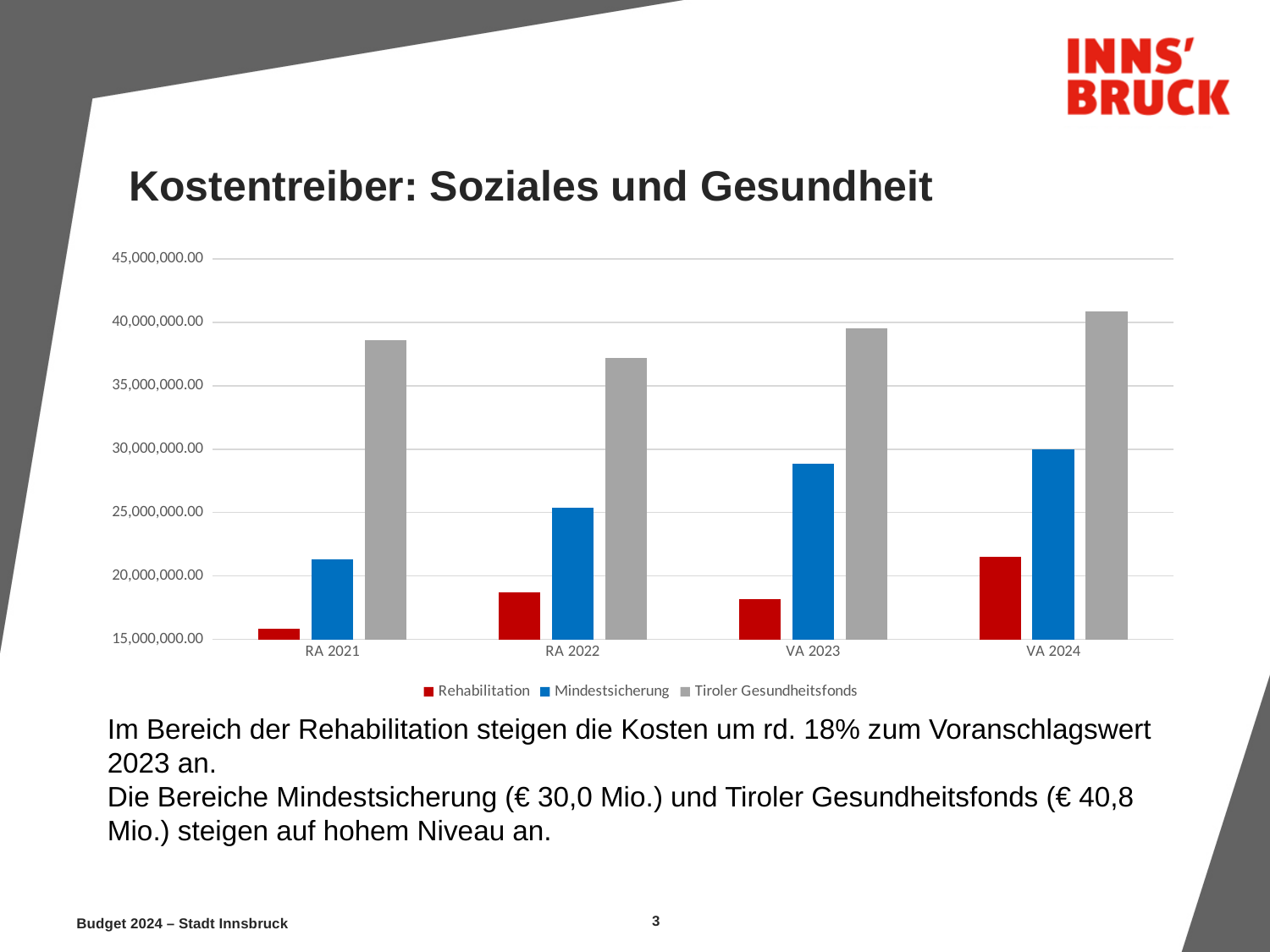
In which category is the Rehabilitation bar lowest? RA 2021 What is the title of the slide containing the chart? Kostentreiber: Soziales und Gesundheit In which category is the Tiroler Gesundheitsfonds bar lowest? RA 2022 Is the Mindestsicherung value for VA 2023 greater or less than 30,000,000.00? less In which category is the Tiroler Gesundheitsfonds bar highest? VA 2024 How many series does the legend list? 3 Is the Rehabilitation value for VA 2024 greater or less than 20,000,000.00? greater Which is larger for Tiroler Gesundheitsfonds: RA 2021 or RA 2022? RA 2021 What kind of chart is shown on the slide? bar chart Is the Mindestsicherung value for RA 2021 greater or less than 25,000,000.00? less Do the Mindestsicherung values rise or fall from RA 2021 to VA 2024? rise How many categories are shown on the x axis? 4